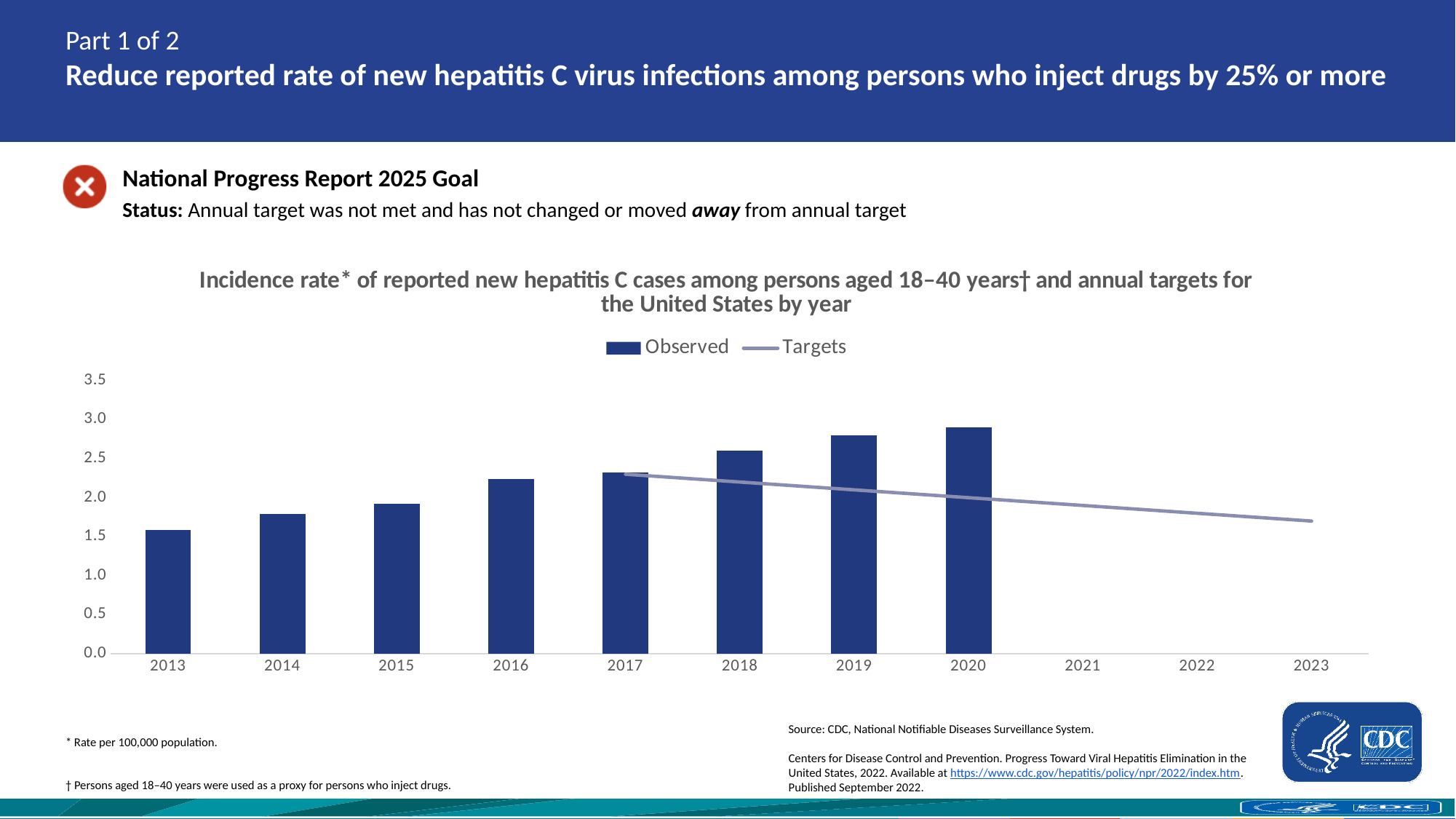
How many years have an Observed bar plotted? 8 Do the observed values rise or fall from 2013 to 2020? rise Is the observed value for 2013 greater or less than 2.0? less How many series does the legend list? 2 What are the two series named in the legend? Observed and Targets Is the observed value for 2020 greater or less than 2.5? greater Which year has the lowest observed incidence rate? 2013 Is the Targets value for 2023 greater or less than 2.0? less Which is larger, the observed value for 2020 or the observed value for 2013? 2020 Which year has the highest observed incidence rate? 2020